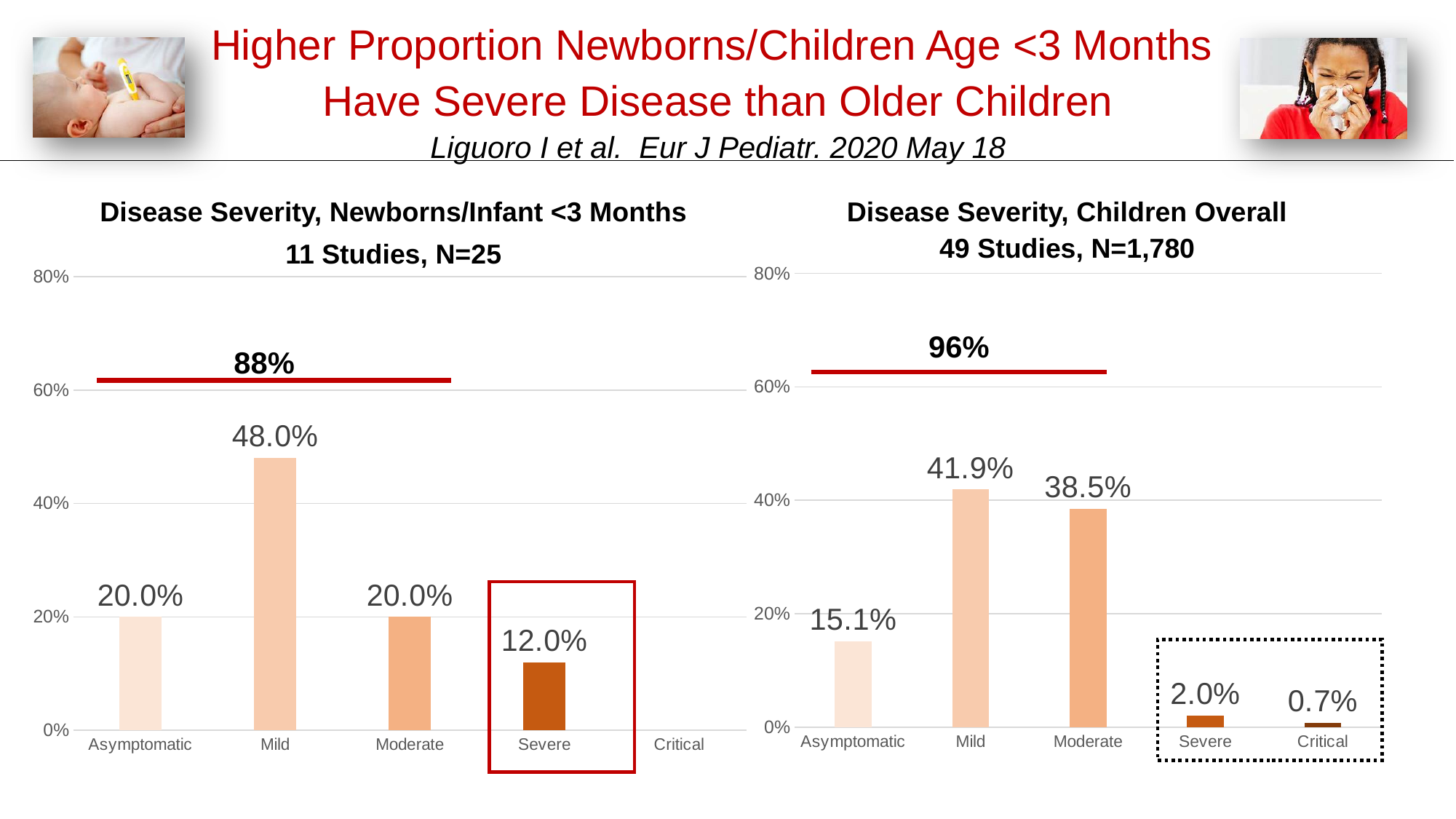
Which is larger: the Severe value in the 'Disease Severity, Newborns/Infant <3 Months' chart or the Severe value in the 'Disease Severity, Children Overall' chart? Newborns/Infant <3 Months In the 'Disease Severity, Children Overall' chart, what is the value for Moderate? 38.5% In the 'Disease Severity, Newborns/Infant <3 Months' chart, what is the value for Mild? 48.0% In the 'Disease Severity, Children Overall' chart, what is the difference between the Mild and Moderate values? 3.4% What kind of chart is the 'Disease Severity, Newborns/Infant <3 Months' chart? Bar chart In the 'Disease Severity, Children Overall' chart, what percentage is written above the red line spanning Asymptomatic to Moderate? 96% In the 'Disease Severity, Newborns/Infant <3 Months' chart, what is the difference between the Mild and Severe values? 36.0% How many categories are shown on the x axis of the 'Disease Severity, Children Overall' chart? 5 In the 'Disease Severity, Children Overall' chart, which category has the lowest value? Critical In the 'Disease Severity, Children Overall' chart, what is the value for Critical? 0.7% In the 'Disease Severity, Newborns/Infant <3 Months' chart, what is the value for Severe? 12.0% In the 'Disease Severity, Newborns/Infant <3 Months' chart, which category has the highest value? Mild